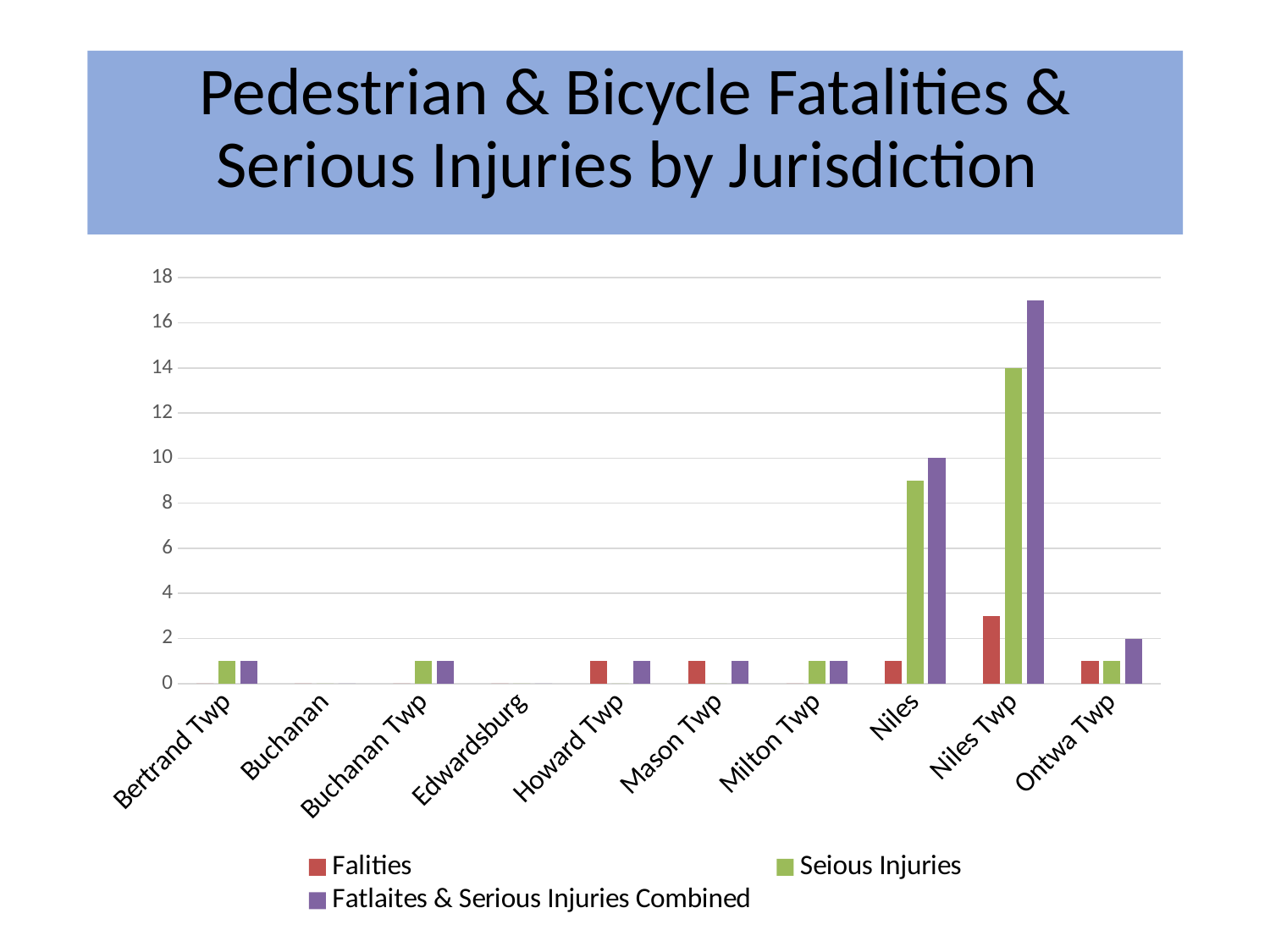
Which colour represents the Seious Injuries series in the legend? green What kind of chart is shown on the slide? bar chart How many jurisdictions are shown on the x axis? 10 What is the Seious Injuries value for Niles Twp? 14 What is the title of the chart on the slide? Pedestrian & Bicycle Fatalities & Serious Injuries by Jurisdiction What is the Fatlaites & Serious Injuries Combined value for Niles? 10 How many series does the legend list? 3 Is the Fatlaites & Serious Injuries Combined value for Niles Twp greater or less than 16? greater Which jurisdiction has the highest value for Fatlaites & Serious Injuries Combined? Niles Twp Is the Seious Injuries value for Niles greater or less than 8? greater Is the Falities value for Niles Twp greater or less than 4? less Which has the larger Fatlaites & Serious Injuries Combined value, Niles or Niles Twp? Niles Twp